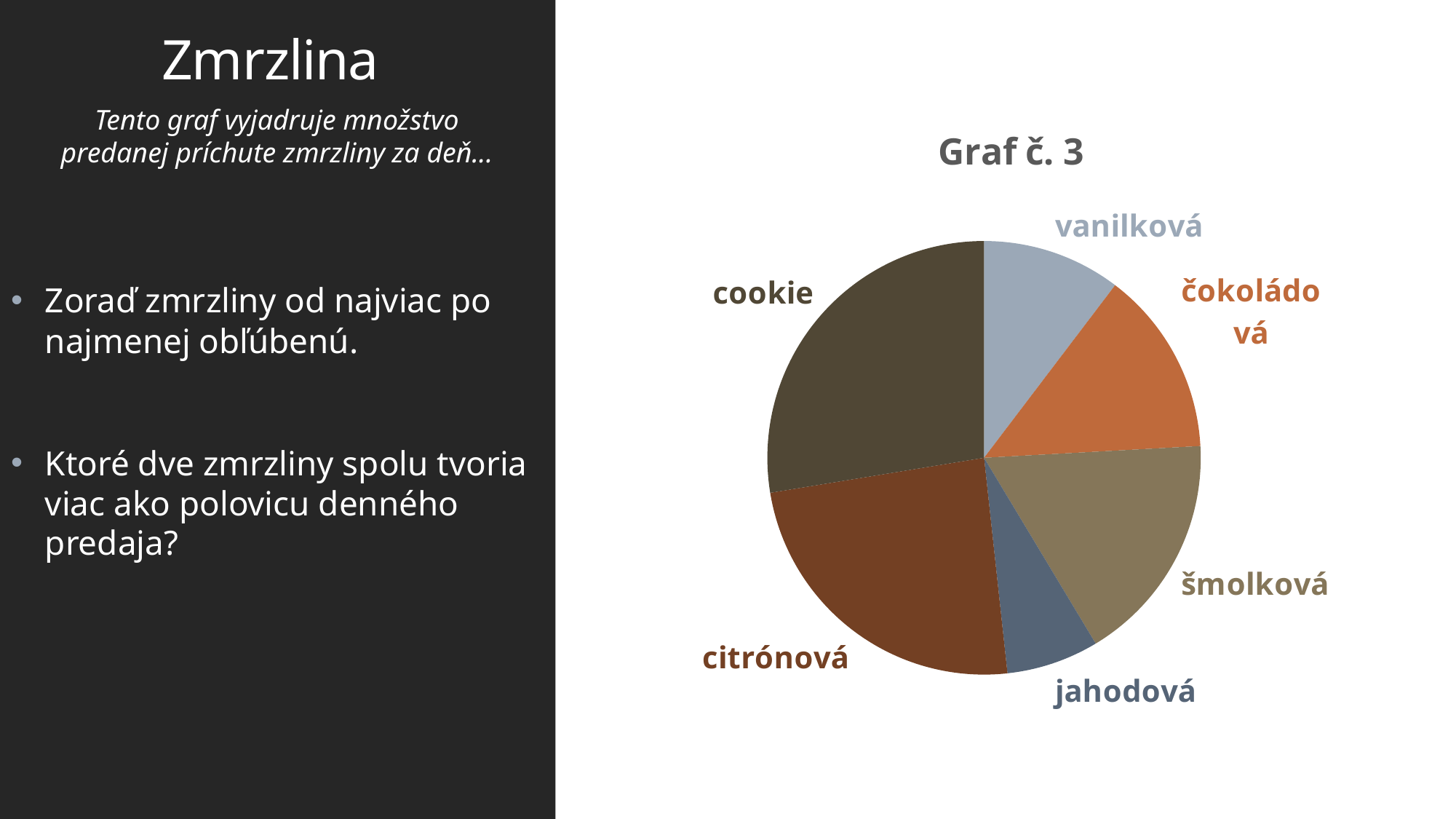
How many slices does the pie chart have? 6 Which flavour has the largest slice of the pie? cookie What kind of chart is shown on the slide? pie chart Which slice is larger, citrónová or jahodová? citrónová Which slice is larger, cookie or citrónová? cookie What is the title of the chart? Graf č. 3 Which slice is larger, šmolková or vanilková? šmolková Which flavour's slice is labelled at the top of the pie, next to čokoládová? vanilková